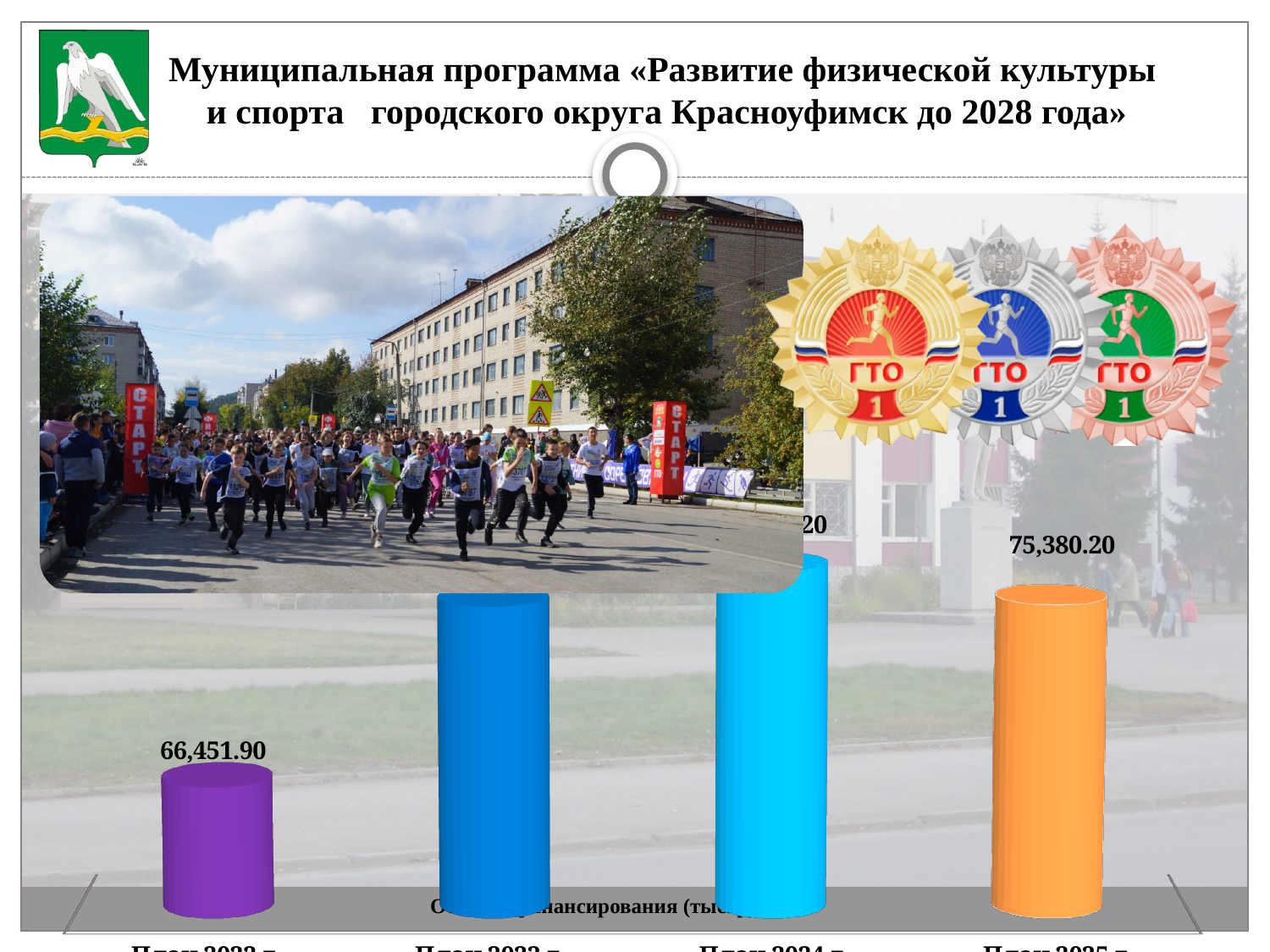
What colour is the rightmost bar? orange How many bars does the chart show? 4 What is the value shown above the leftmost (purple) bar? 66,451.90 What colour is the leftmost bar? purple Which bar has the lowest value? the leftmost (purple) bar What is the value shown above the rightmost (orange) bar? 75,380.20 What is the difference between the rightmost bar's value and the leftmost bar's value? 8,928.30 What kind of chart is shown on the slide? bar chart Which is larger, the value of the leftmost bar or the value of the rightmost bar? the rightmost bar